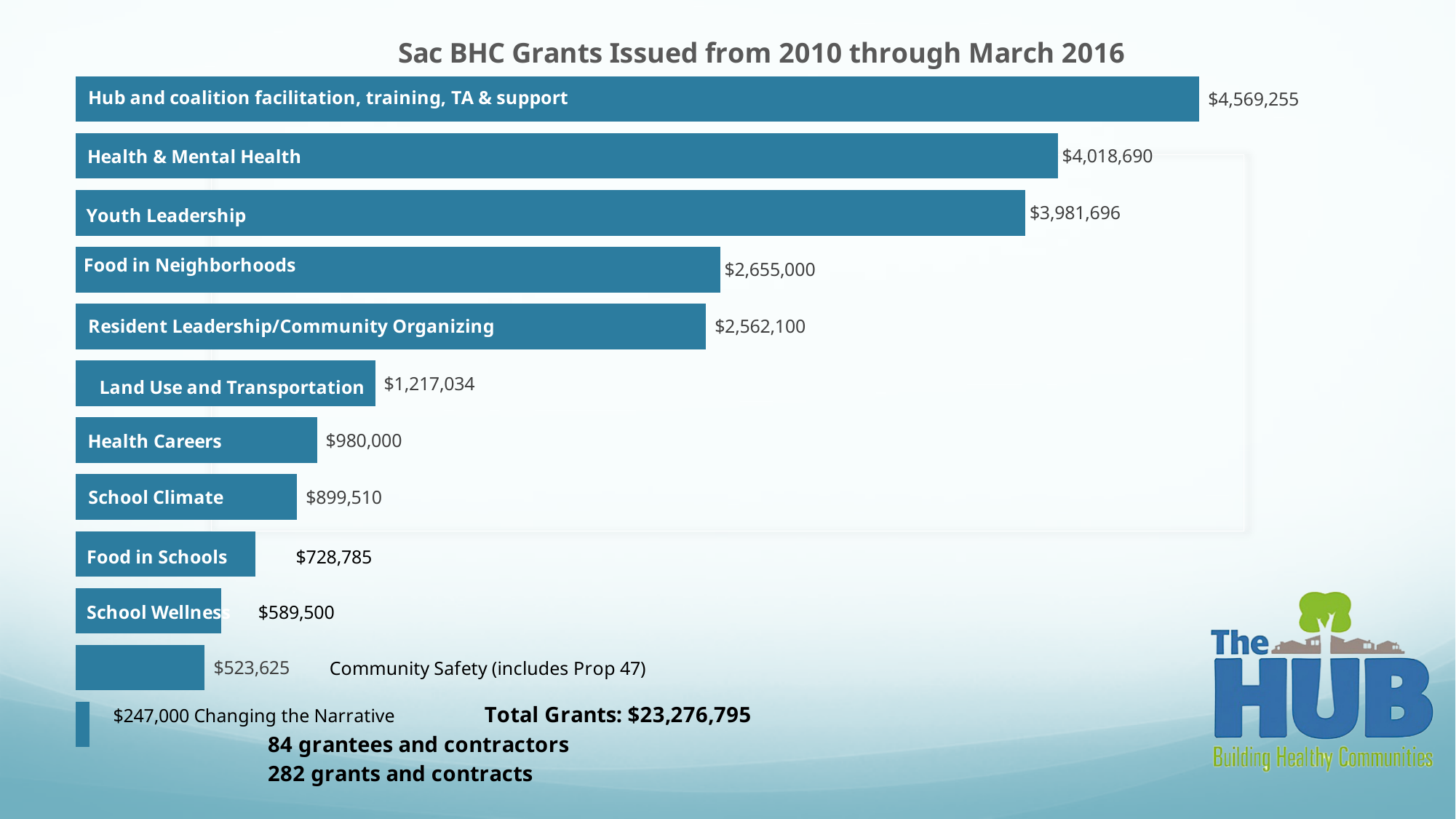
What is the difference between the amounts for Health Careers and School Climate? $80,490 What type of chart is shown on the slide? Bar chart What is the difference between the amounts for Food in Neighborhoods and Resident Leadership/Community Organizing? $92,900 How much was issued for Land Use and Transportation? $1,217,034 How many categories are shown in the chart? 12 Which category received the smallest grant amount? Changing the Narrative What is the title of the chart? Sac BHC Grants Issued from 2010 through March 2016 Which category received the largest grant amount? Hub and coalition facilitation, training, TA & support What is the value shown for School Climate? $899,510 What is the grant amount for Youth Leadership? $3,981,696 Which received more grant money, Food in Schools or School Wellness? Food in Schools What is the grant amount for Community Safety (includes Prop 47)? $523,625